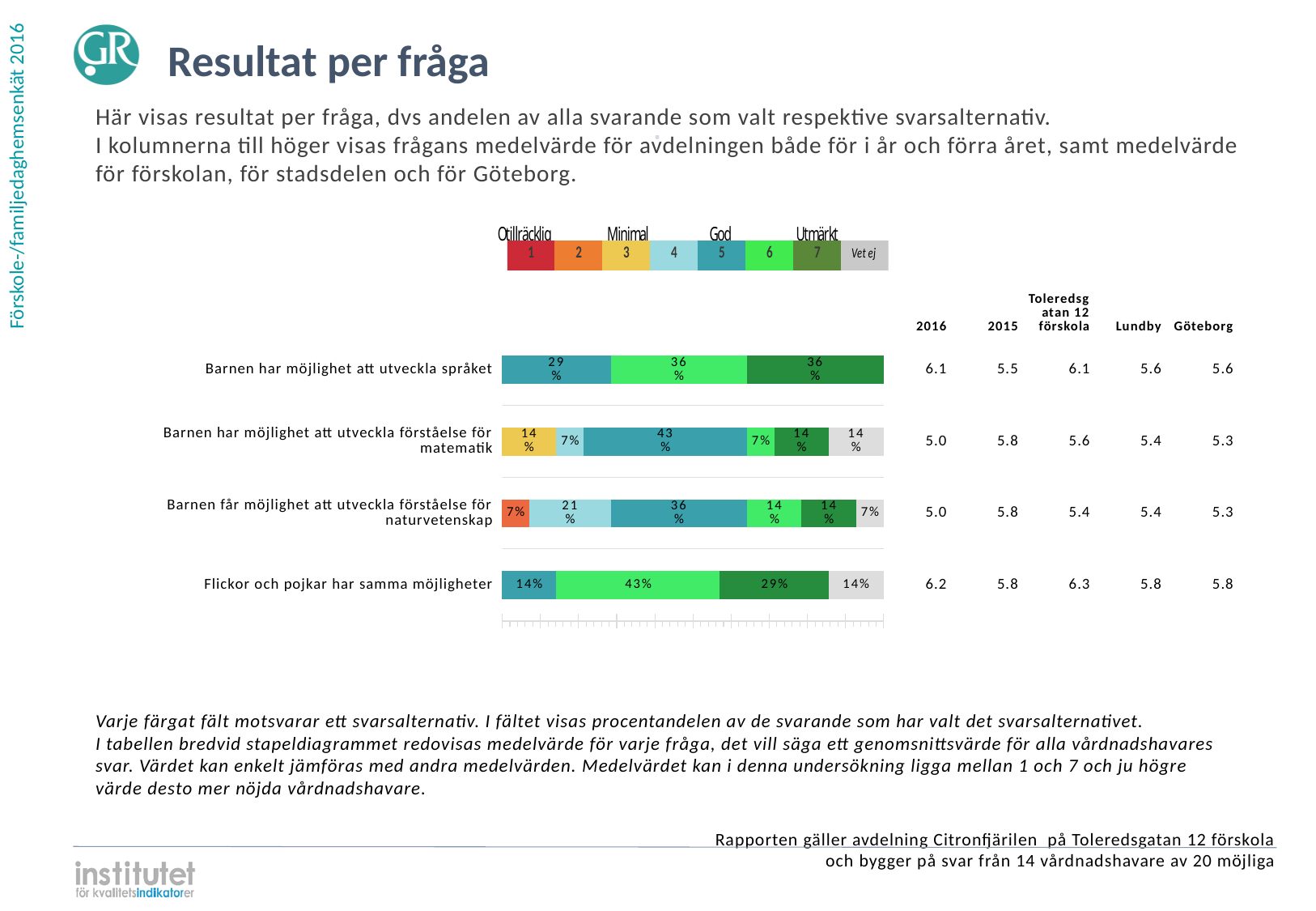
What percentage of respondents answered "Vet ej" for "Flickor och pojkar har samma möjligheter"? 14% What kind of chart is shown on the slide? Stacked bar chart Which is larger: the option 6 share for "Flickor och pojkar har samma möjligheter" or the option 6 share for "Barnen har möjlighet att utveckla språket"? Flickor och pojkar har samma möjligheter Which question has the largest share of respondents choosing option 7 (Utmärkt)? Barnen har möjlighet att utveckla språket How many questions (categories) are plotted in the bar chart? 4 What label does the legend give to response option 1? Otillräcklig What is the difference between the option 5 share for "Barnen har möjlighet att utveckla förståelse för matematik" (43%) and the option 5 share for "Barnen har möjlighet att utveckla språket" (29%)? 14% What percentage of respondents chose option 7 (Utmärkt) for "Barnen har möjlighet att utveckla språket"? 36% What percentage of respondents chose option 2 for "Barnen får möjlighet att utveckla förståelse för naturvetenskap"? 7% How many response options does the colour legend above the chart list? 8 What percentage of respondents chose option 5 for "Barnen har möjlighet att utveckla förståelse för matematik"? 43% What is the 2016 mean value shown for "Flickor och pojkar har samma möjligheter"? 6.2